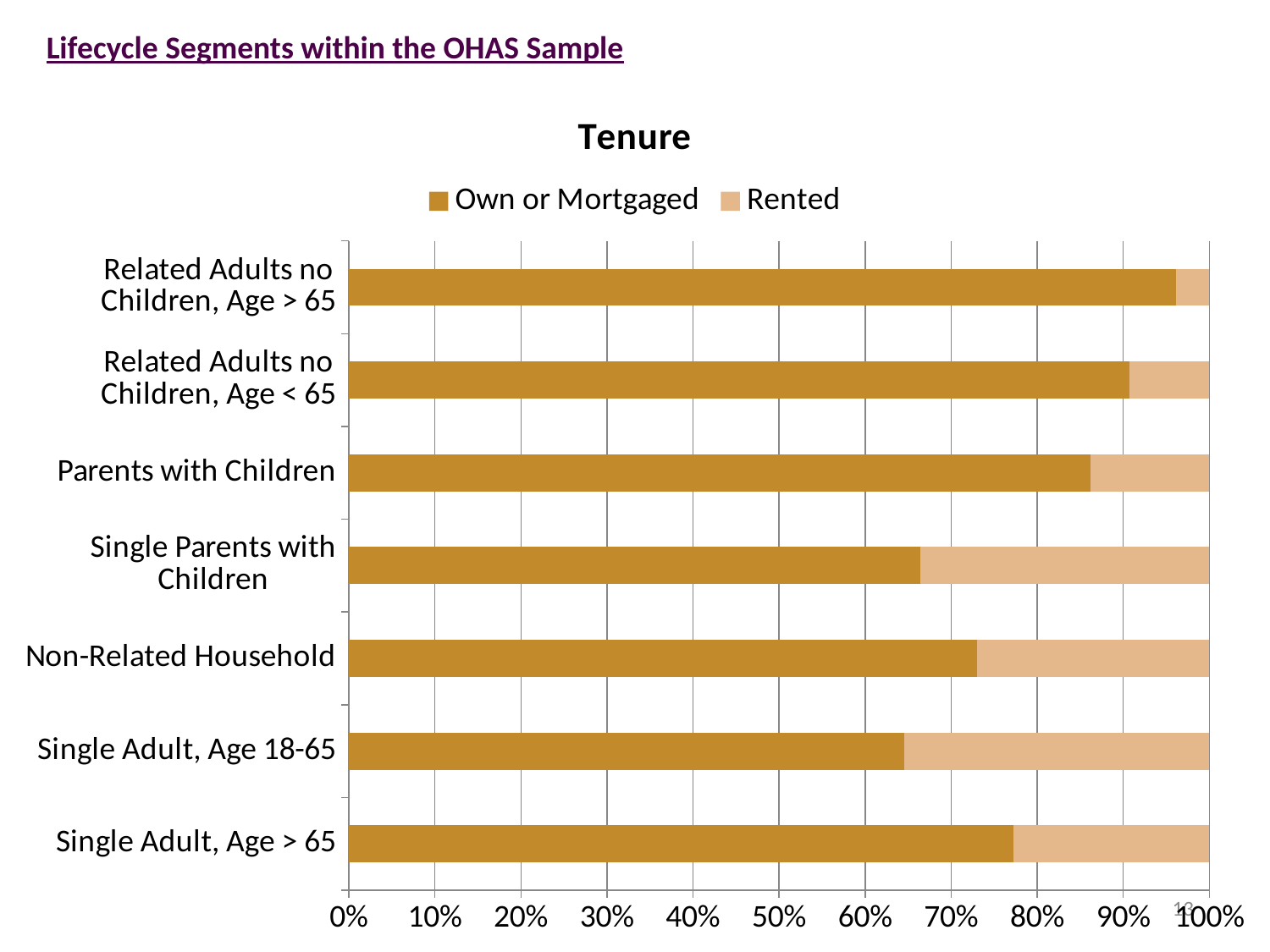
Which has the larger Rented share: Single Adult, Age > 65 or Parents with Children? Single Adult, Age > 65 Is the Own or Mortgaged value for Related Adults no Children, Age > 65 greater or less than 90%? greater Is the Own or Mortgaged value for Single Adult, Age > 65 greater or less than 80%? less Is the Own or Mortgaged value for Single Adult, Age 18-65 greater or less than 60%? greater How many lifecycle segments (categories) are plotted in the chart? 7 How many series does the legend list? 2 Which lifecycle segment has the highest Own or Mortgaged share? Related Adults no Children, Age > 65 Which has the larger Own or Mortgaged share: Non-Related Household or Single Parents with Children? Non-Related Household What kind of chart is shown on the slide? bar chart What is the title of the chart? Tenure